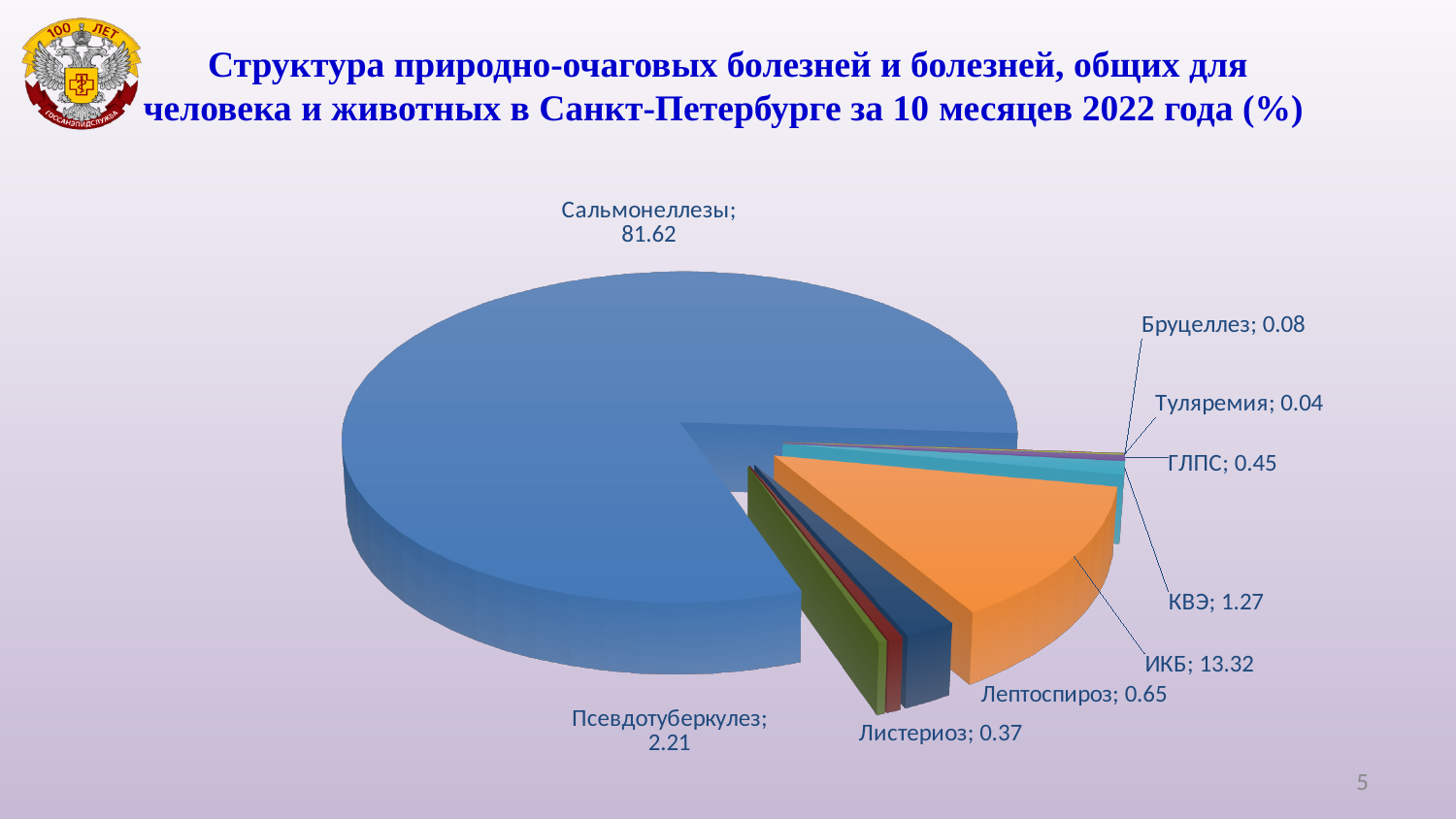
What type of chart is shown on the slide? pie chart What is the difference between the values for Сальмонеллезы and ИКБ? 68.30 Which category has the largest slice of the pie? Сальмонеллезы What is the value for Лептоспироз? 0.65 Which is larger, the value for КВЭ or the value for ГЛПС? КВЭ How many categories are shown in the pie chart? 9 What is the difference between the values for Псевдотуберкулез and Листериоз? 1.84 What is the value for ИКБ? 13.32 What is the value for Сальмонеллезы? 81.62 Which category has the smallest value? Туляремия What is the value for Псевдотуберкулез? 2.21 What is the value for Туляремия? 0.04